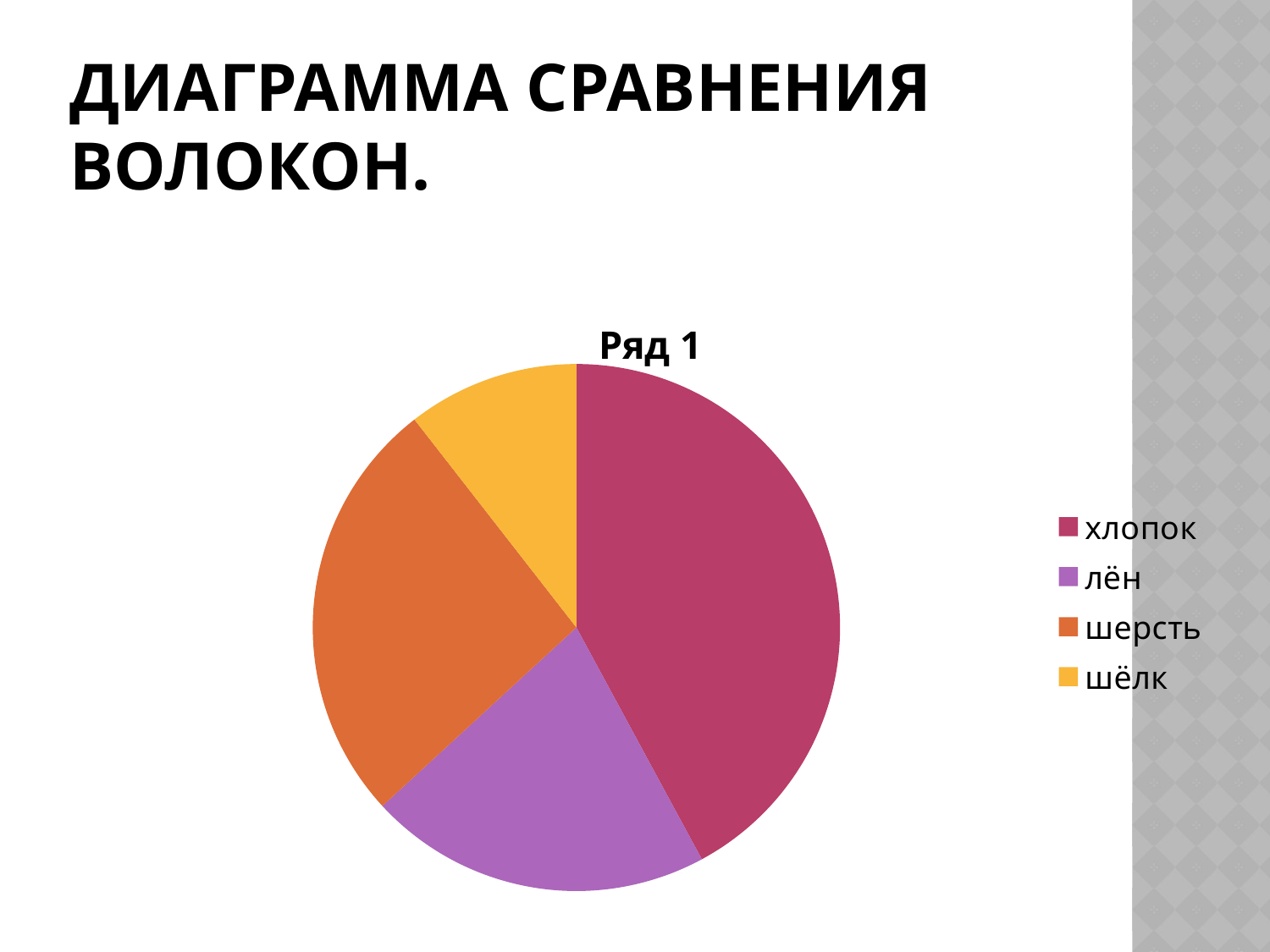
Which slice is larger, шерсть or шёлк? шерсть Which category has the smallest slice of the pie? шёлк What kind of chart is shown on the slide? pie chart How many slices does the pie chart have? 4 Which category has the largest slice of the pie? хлопок Which slice is larger, хлопок or шерсть? хлопок Which slice is larger, хлопок or лён? хлопок What is the title shown above the pie chart? Ряд 1 What colour is the slice for шёлк? yellow How many entries does the legend list? 4